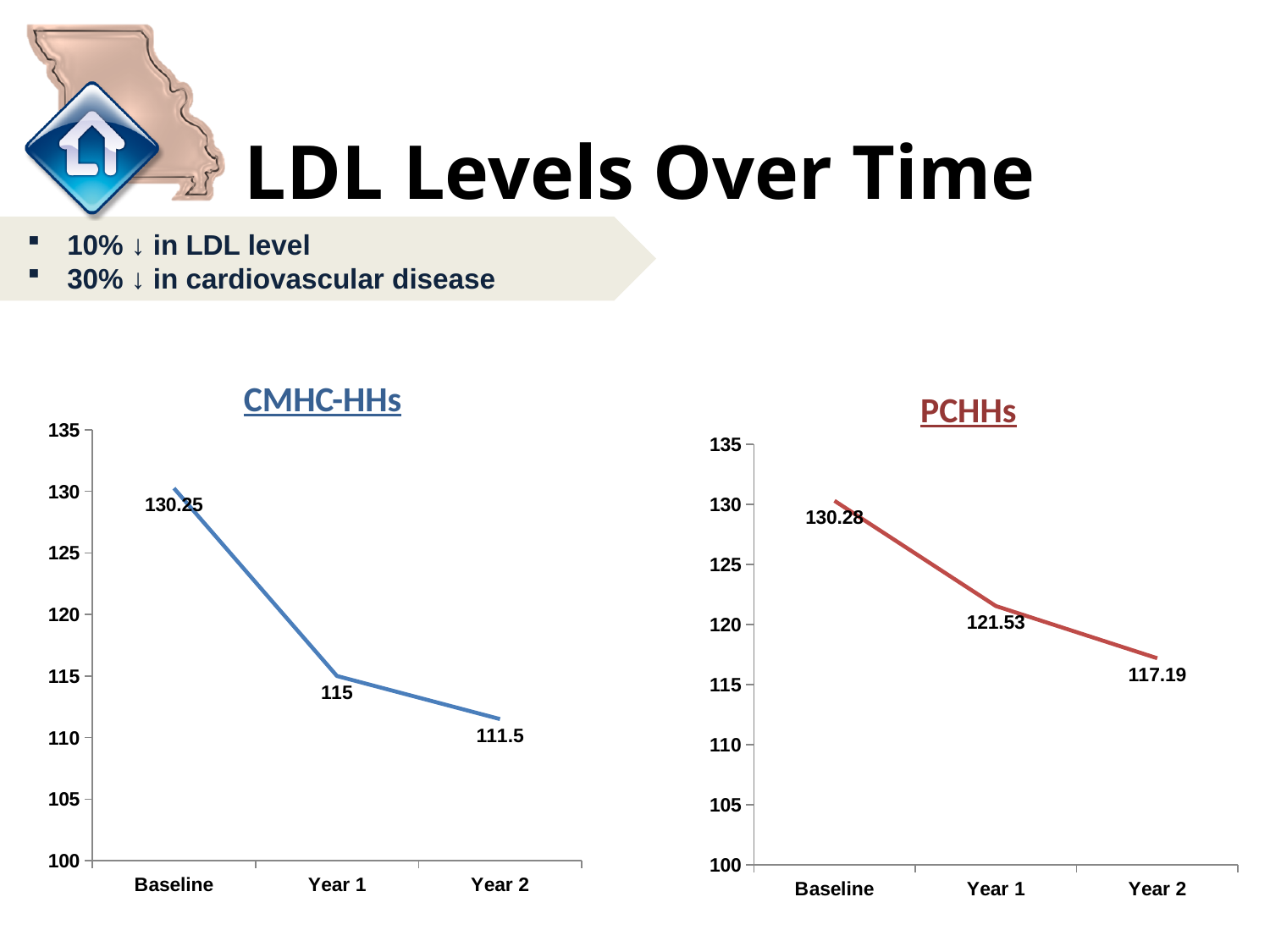
In the PCHHs chart, what is the value at Year 2? 117.19 In the CMHC-HHs chart, which time point has the lowest value? Year 2 Which is larger: the Year 2 value in the CMHC-HHs chart or the Year 2 value in the PCHHs chart? PCHHs In the CMHC-HHs chart, what is the LDL value at Baseline? 130.25 In the PCHHs chart, what is the difference between the Year 1 and Year 2 values? 4.34 In the PCHHs chart, which time point has the highest value? Baseline In the PCHHs chart, what is the value at Year 1? 121.53 In the CMHC-HHs chart, what is the difference between the Baseline and Year 1 values? 15.25 How many time points are plotted in the CMHC-HHs chart? 3 What kind of chart is the PCHHs chart? line chart In the PCHHs chart, do the values rise or fall from Baseline to Year 2? fall In the CMHC-HHs chart, what is the value at Year 2? 111.5